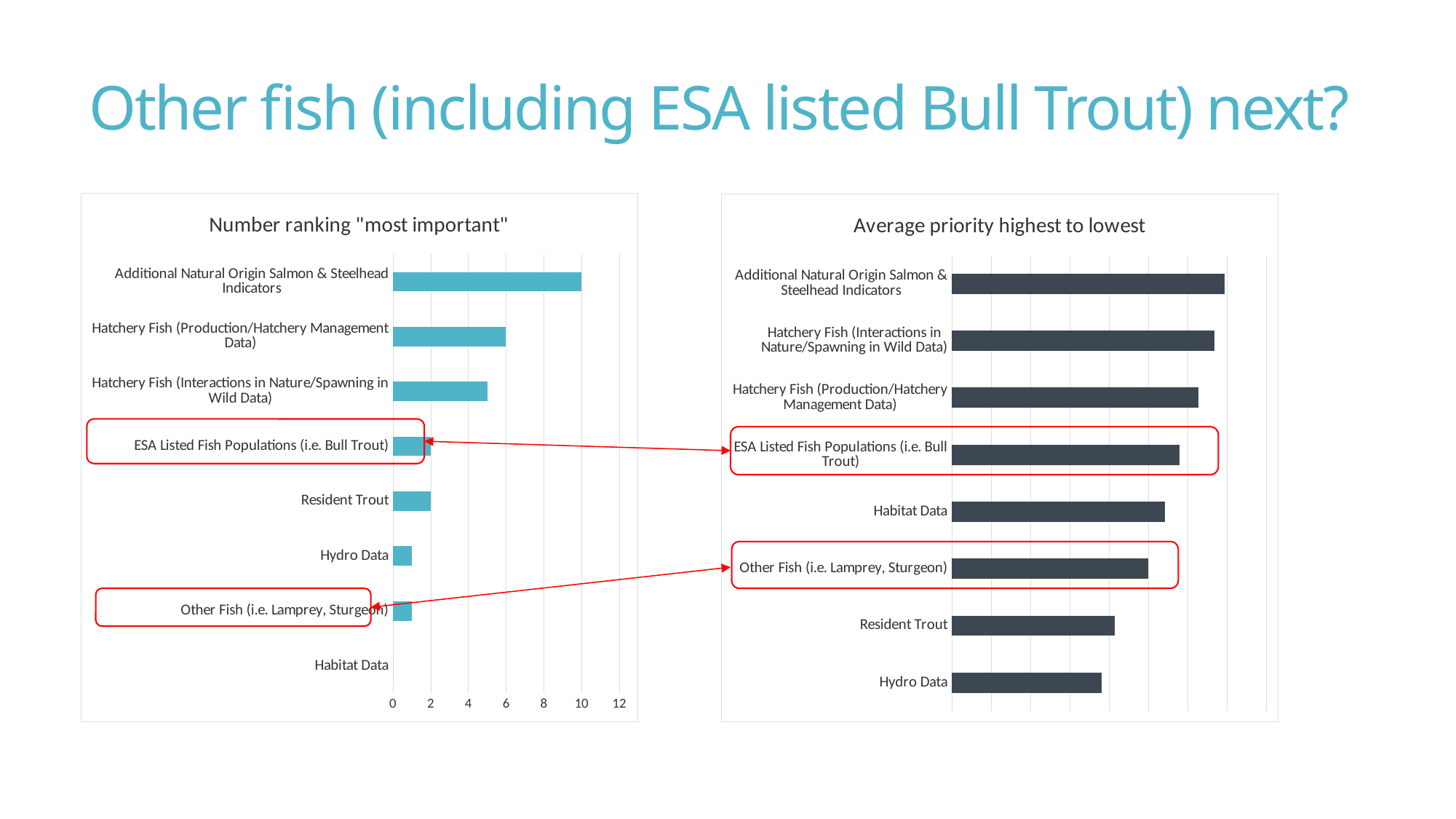
In the "Average priority highest to lowest" chart, which category has the shortest bar? Hydro Data In the "Number ranking "most important"" chart, what is the value for Resident Trout? 2 What is the title of the chart on the right side of the slide? Average priority highest to lowest In the "Number ranking "most important"" chart, what is the difference between Additional Natural Origin Salmon & Steelhead Indicators and Hatchery Fish (Production/Hatchery Management Data)? 4 In the "Number ranking "most important"" chart, is the value for Hatchery Fish (Interactions in Nature/Spawning in Wild Data) greater or less than 4? greater In the "Number ranking "most important"" chart, which category has the highest value? Additional Natural Origin Salmon & Steelhead Indicators What kind of chart is the "Number ranking "most important"" chart on the left? Bar chart In the "Average priority highest to lowest" chart, which category has the longest bar? Additional Natural Origin Salmon & Steelhead Indicators In the "Number ranking "most important"" chart, what is the value for Hatchery Fish (Production/Hatchery Management Data)? 6 In the "Number ranking "most important"" chart, what is the value for Additional Natural Origin Salmon & Steelhead Indicators? 10 In the "Number ranking "most important"" chart, which category has the lowest value? Habitat Data In the "Number ranking "most important"" chart, how many categories are listed? 8